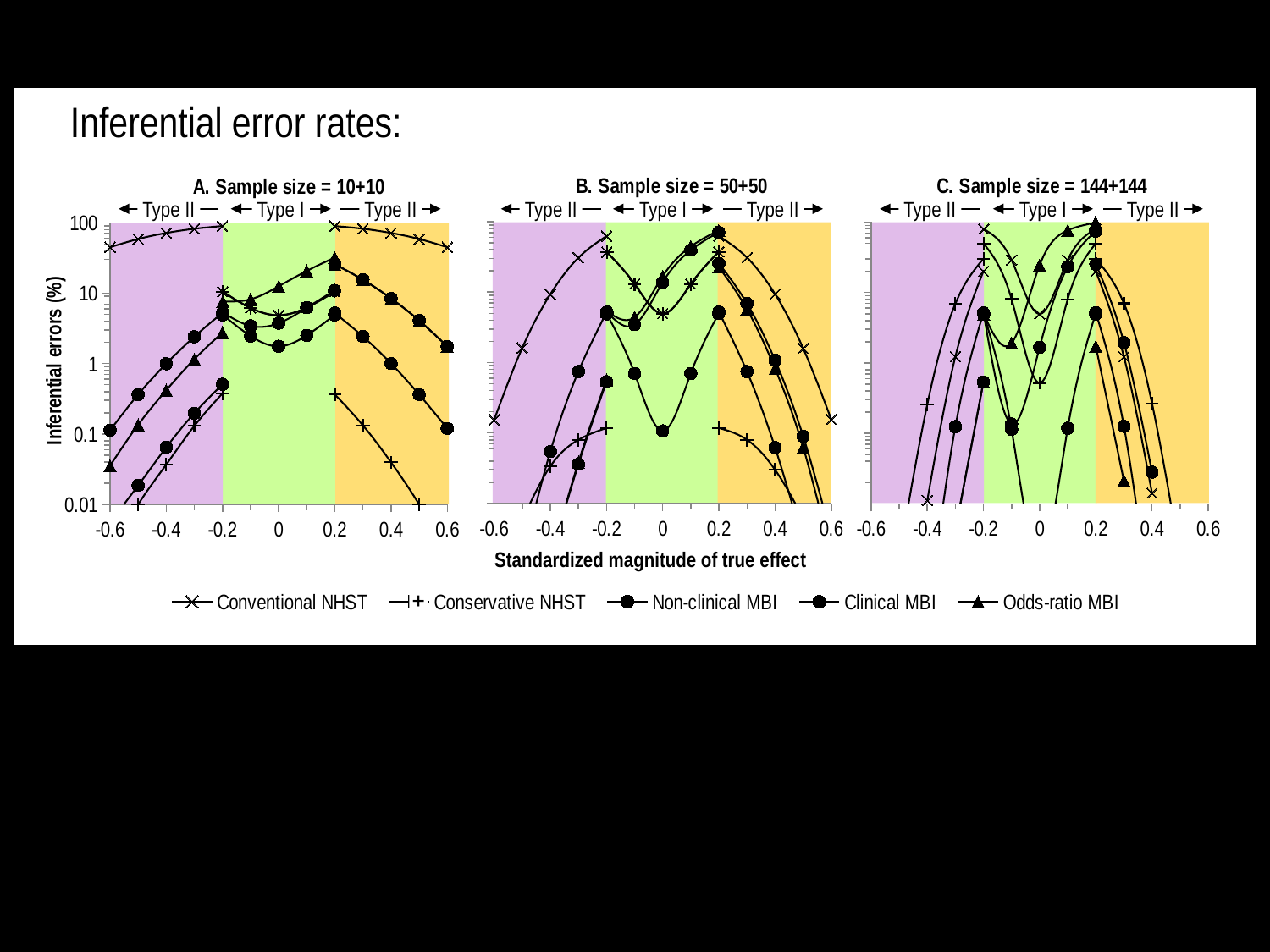
What is the x-axis title shared by the three charts? Standardized magnitude of true effect What is the title of the rightmost chart? C. Sample size = 144+144 In chart A (Sample size = 10+10), is the value for Odds-ratio MBI at a true effect of -0.6 greater or less than 0.1? less How many series does the legend list for the charts? 5 In chart C (Sample size = 144+144), is the value for Conventional NHST at a true effect of -0.4 greater or less than 0.1? less In chart A (Sample size = 10+10), is the value for Conservative NHST at a true effect of 0.4 greater or less than 0.1? less In chart A (Sample size = 10+10), at a true effect of 0.2, which is larger: Conventional NHST or Conservative NHST? Conventional NHST In chart A (Sample size = 10+10), does the Conventional NHST line rise or fall from a true effect of -0.6 to -0.2? Rise In chart A (Sample size = 10+10), does the Conservative NHST line rise or fall from a true effect of 0.2 to 0.5? Fall What kind of chart is used in panel A (Sample size = 10+10)? Line chart